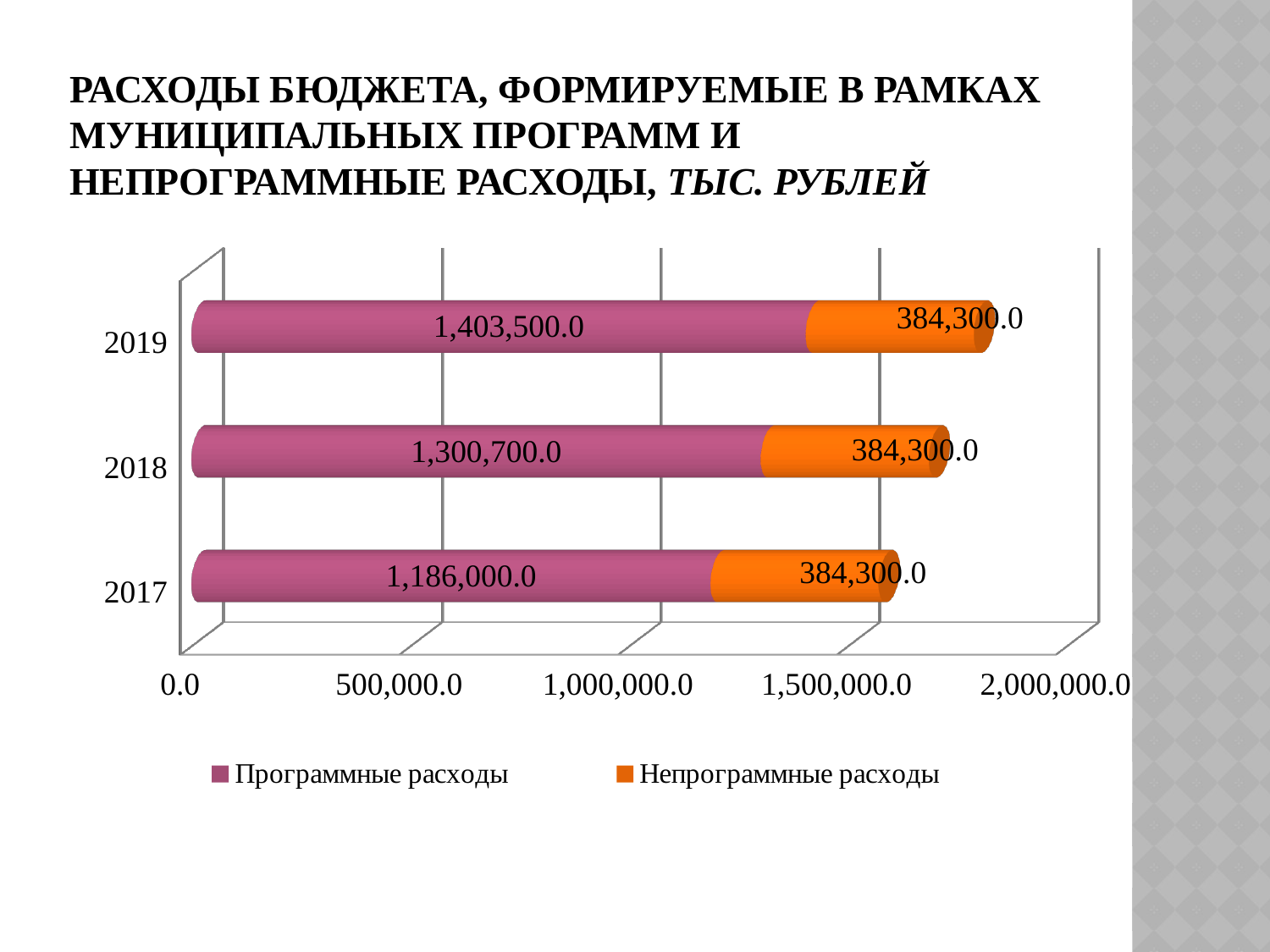
Which year has the lowest value of Программные расходы? 2017 What is the value of Программные расходы for 2019? 1,403,500.0 How many series does the legend list? 2 What is the value of Программные расходы for 2017? 1,186,000.0 What is the difference between Программные расходы in 2018 and in 2017? 114,700.0 Which year has the highest value of Программные расходы? 2019 What is the total of the stacked bar for 2019? 1,787,800.0 How many years are shown on the chart? 3 What is the value of Непрограммные расходы for 2018? 384,300.0 What is the difference between Программные расходы in 2019 and in 2018? 102,800.0 What is the total of the stacked bar for 2017? 1,570,300.0 Which is larger: Программные расходы in 2018 or in 2017? 2018